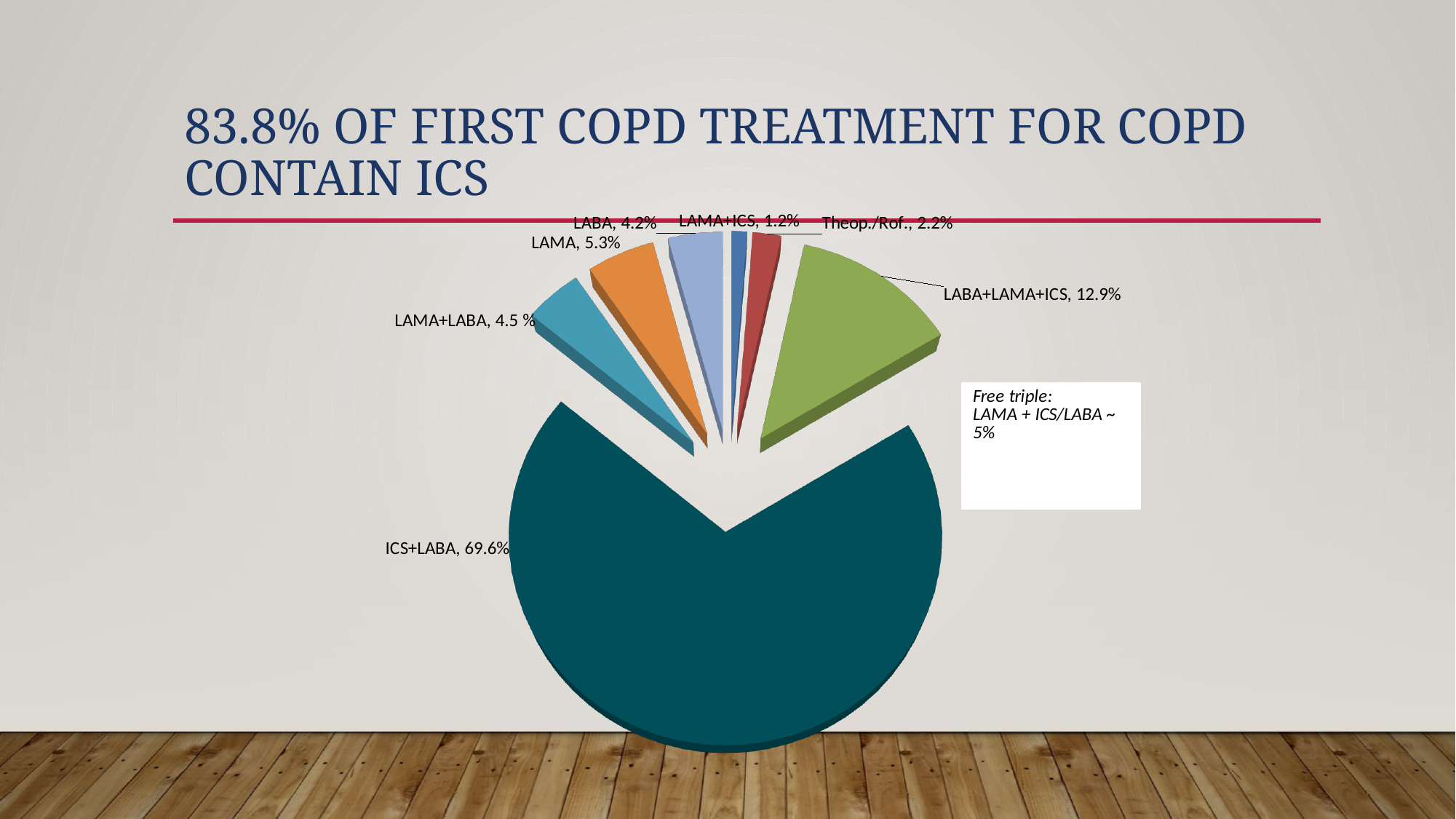
According to the slide title, what percentage of first COPD treatments contain ICS? 83.8% What percentage is shown for LABA+LAMA+ICS? 12.9% How many slices does the pie chart have? 7 What percentage is shown for LAMA+ICS? 1.2% What kind of chart is shown on the slide? Pie chart Which category has the smallest slice of the pie? LAMA+ICS What percentage is shown for Theop./Rof.? 2.2% What is the difference in percentage points between ICS+LABA and LABA+LAMA+ICS? 56.7 Which category has the largest slice of the pie? ICS+LABA Which is larger, the share for LAMA or the share for LABA? LAMA What percentage is shown for LAMA? 5.3% What share of first COPD treatments is ICS+LABA? 69.6%